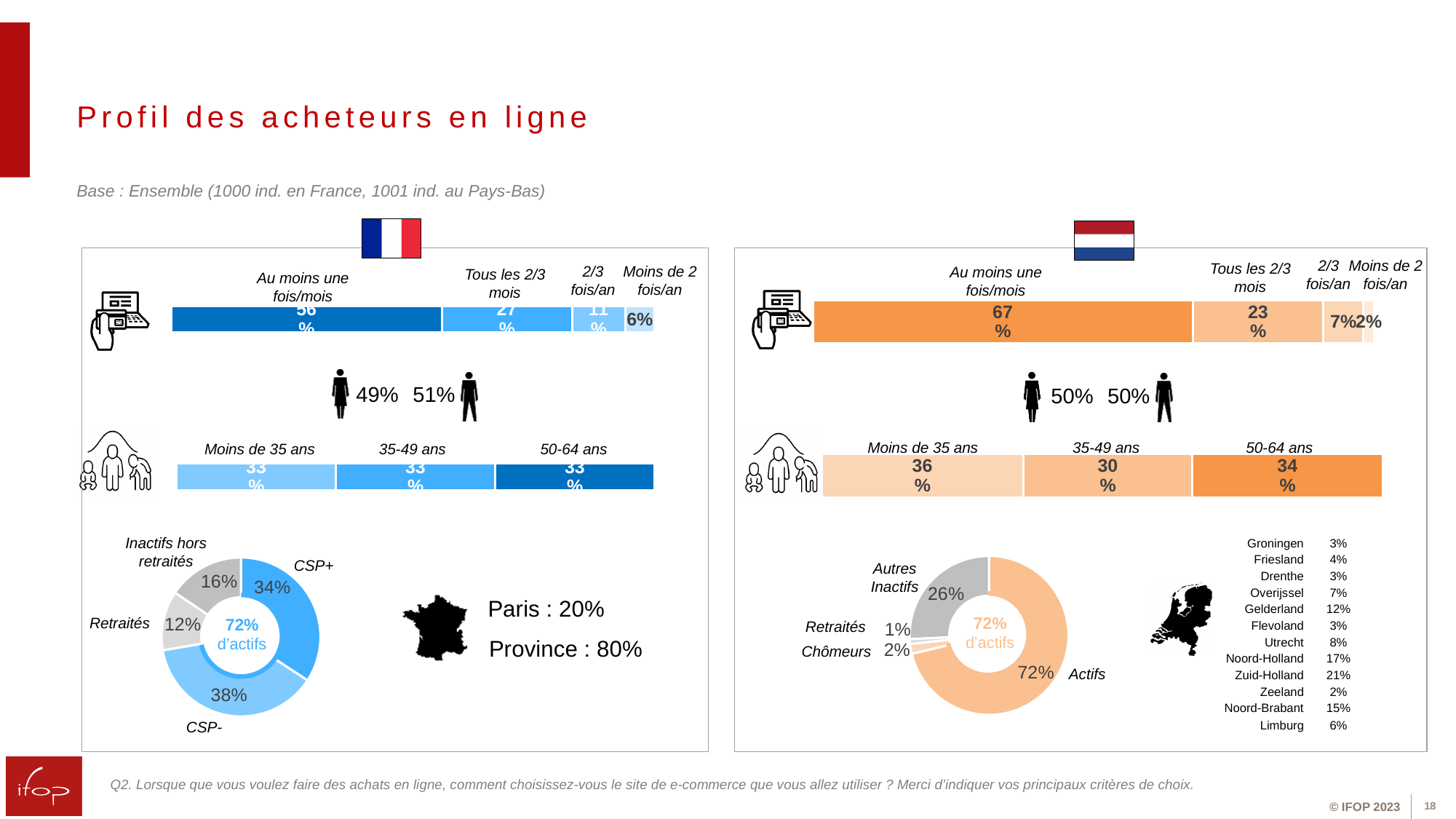
In the Netherlands age bar chart, what is the share of the 35-49 ans group? 30% In the France frequency bar chart, what share of respondents buy online at least once a month (Au moins une fois/mois)? 56% In the Netherlands province list, which province has the highest share? Zuid-Holland What kind of chart is used to show the occupation breakdown (CSP+, CSP-, Retraités, Inactifs) in the France panel? Donut (pie) chart In the Netherlands donut chart, what share is Autres Inactifs? 26% In the Netherlands donut chart, which is larger: Chômeurs or Retraités? Chômeurs In the Netherlands age bar chart, which age group has the largest share? Moins de 35 ans In the Netherlands frequency bar chart, what is the difference between the 'Au moins une fois/mois' share and the 'Tous les 2/3 mois' share? 44 points In the France donut chart, what share is CSP-? 38% In the France donut chart, which category has the smallest share? Retraités In the France age bar chart, how many age categories are shown? 3 In the Netherlands frequency bar chart, what share of respondents buy online at least once a month (Au moins une fois/mois)? 67%